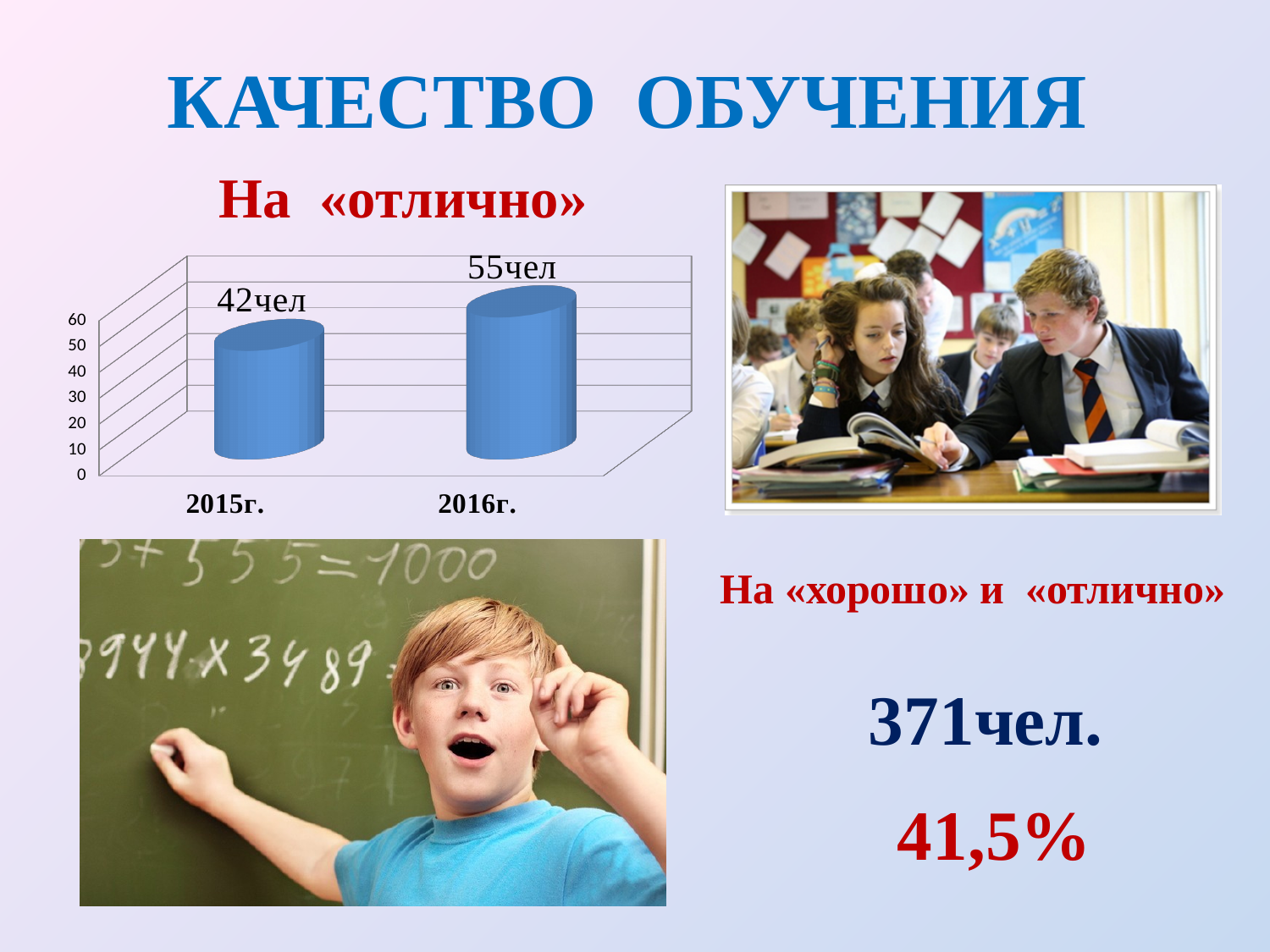
What is the value for 2016г. in the chart? 55чел What kind of chart is shown on the slide? bar chart What is the value for 2015г. in the chart? 42чел What is the heading above the chart? На «отлично» Which year has the higher value in the chart? 2016г. By how much does the value for 2016г. exceed the value for 2015г.? 13 Which year has the lower value in the chart? 2015г. Is the value for 2016г. greater or less than 50? greater Do the values rise or fall from 2015г. to 2016г.? rise Is the value for 2015г. greater or less than 50? less How many categories are shown on the x axis of the chart? 2 Is the value for 2015г. larger or smaller than the value for 2016г.? smaller